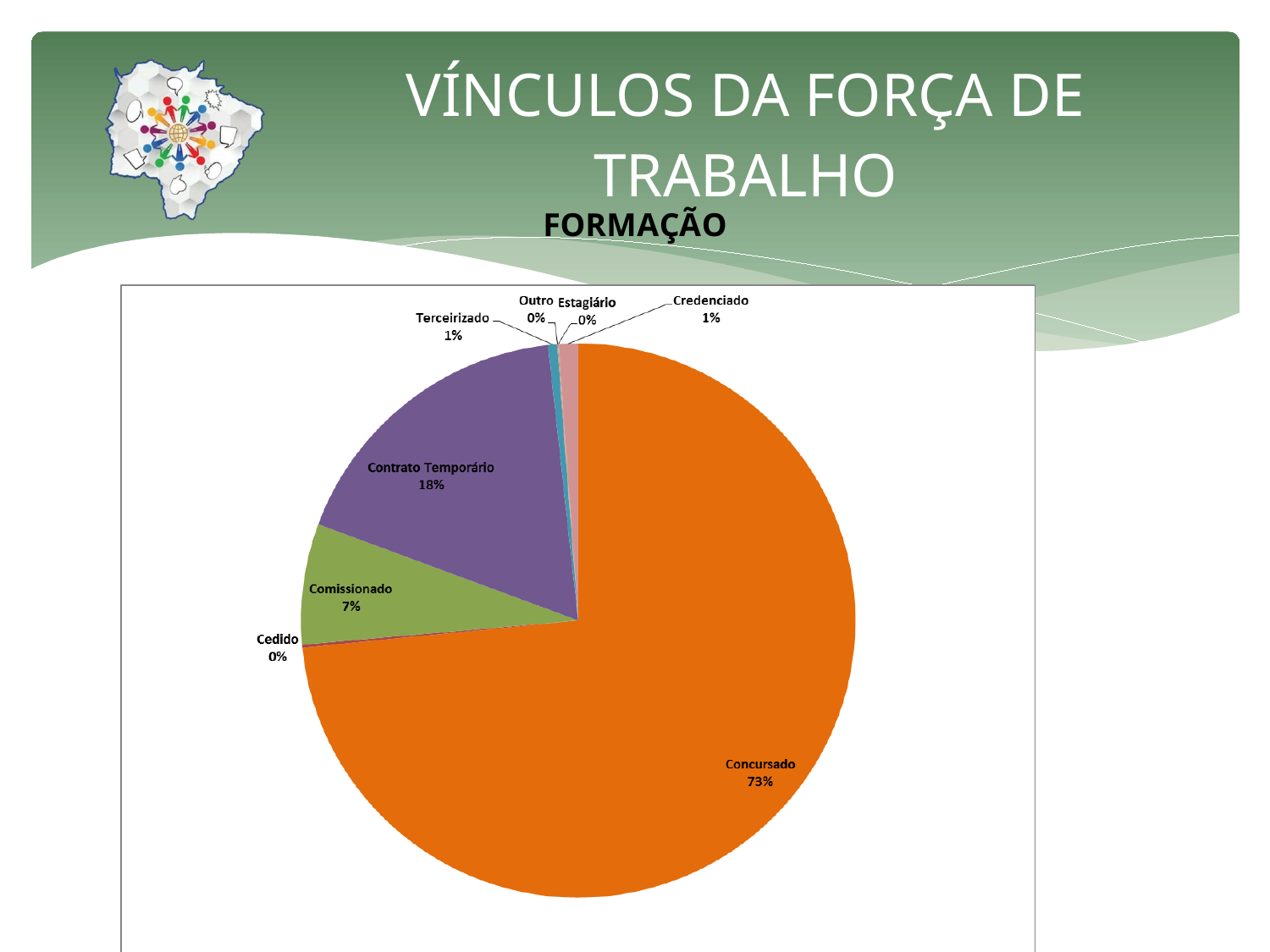
What colour is the Concursado slice? orange What share of the pie does Contrato Temporário represent? 18% How many categories are shown in the pie chart? 8 What kind of chart is shown on the slide? pie chart What is the combined share of Comissionado and Contrato Temporário? 25% What is the value shown for Comissionado? 7% What is the value shown for Credenciado? 1% Which is larger, the share for Comissionado or the share for Contrato Temporário? Contrato Temporário Which category has the largest slice of the pie? Concursado What is the difference between the shares of Concursado and Contrato Temporário? 55% What share of the pie does Concursado represent? 73% What is the value shown for Terceirizado? 1%